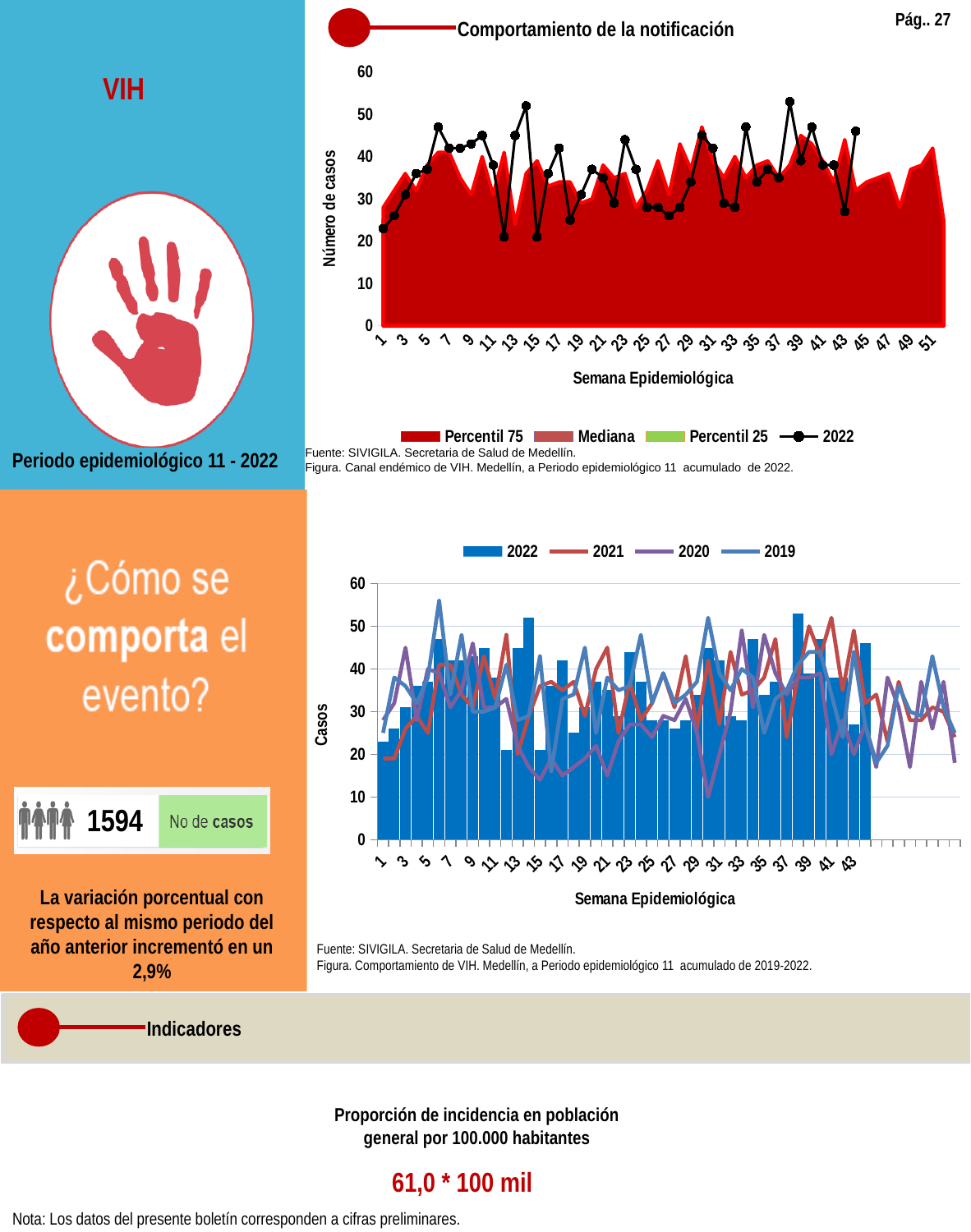
In the bottom chart (Comportamiento de VIH 2019-2022), is the 2022 bar for week 1 greater or less than 30? less In the bottom chart (Comportamiento de VIH 2019-2022), is the 2022 bar for week 14 greater or less than 50? greater What is the y-axis title of the top chart 'Comportamiento de la notificación'? Número de casos In the top chart 'Comportamiento de la notificación', which legend entry is shown in dark red? Percentil 75 In the top chart 'Comportamiento de la notificación', is the 2022 value for week 14 greater or less than 50? greater In the bottom chart (Comportamiento de VIH 2019-2022), what kind of chart is used for the 2022 series? bar chart In the top chart 'Comportamiento de la notificación', which is larger for the 2022 series: week 12 or week 14? week 14 In the bottom chart (Comportamiento de VIH 2019-2022), how many series does the legend list? 4 In the bottom chart (Comportamiento de VIH 2019-2022), which 2022 bar is taller: week 12 or week 38? week 38 In the top chart 'Comportamiento de la notificación', how many series does the legend list? 4